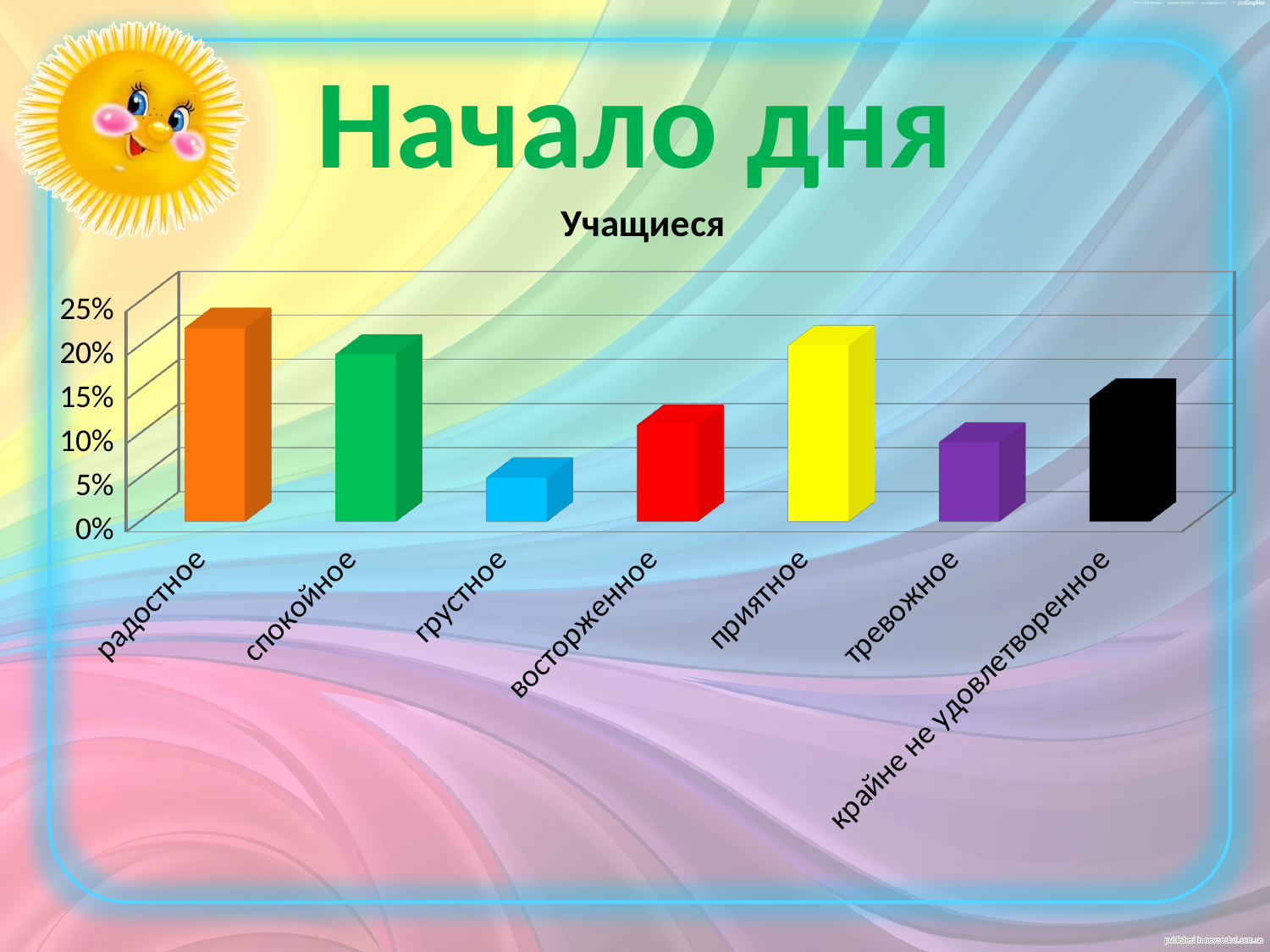
Which category has the lowest value in the chart? грустное What colour is the bar for грустное? blue Is the value for тревожное greater or less than 15%? less Is the value for спокойное greater or less than 15%? greater What is the title of the chart? Учащиеся What kind of chart is shown on the slide? bar chart Is the value for радостное greater or less than 20%? greater Which is larger, the value for радостное or the value for грустное? радостное Which is larger, the value for спокойное or the value for тревожное? спокойное How many categories are shown on the x axis of the chart? 7